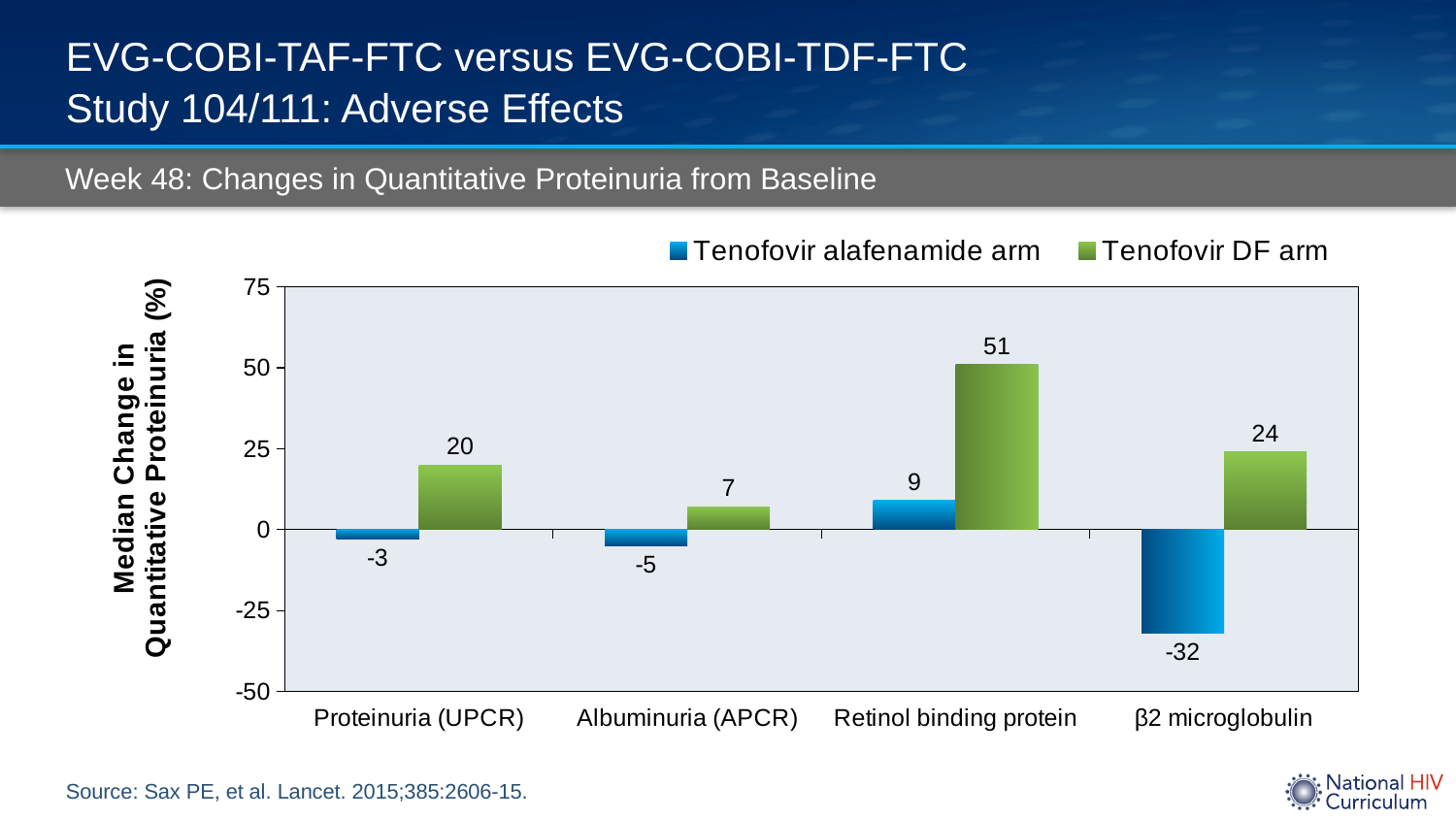
What is the label of the y axis? Median Change in Quantitative Proteinuria (%) What is the value for the Tenofovir DF arm for Proteinuria (UPCR)? 20 What is the value for the Tenofovir alafenamide arm for β2 microglobulin? -32 What is the median change in quantitative proteinuria for the Tenofovir DF arm for Retinol binding protein? 51 What kind of chart is shown on the slide? Bar chart What is the value for the Tenofovir alafenamide arm for Albuminuria (APCR)? -5 Which category has the highest value for the Tenofovir DF arm? Retinol binding protein What is the difference between the Tenofovir DF arm and the Tenofovir alafenamide arm values for Retinol binding protein? 42 Which category has the lowest value for the Tenofovir alafenamide arm? β2 microglobulin For β2 microglobulin, which arm has the larger value? Tenofovir DF arm How many categories are shown on the x axis? 4 How many series does the legend list? 2